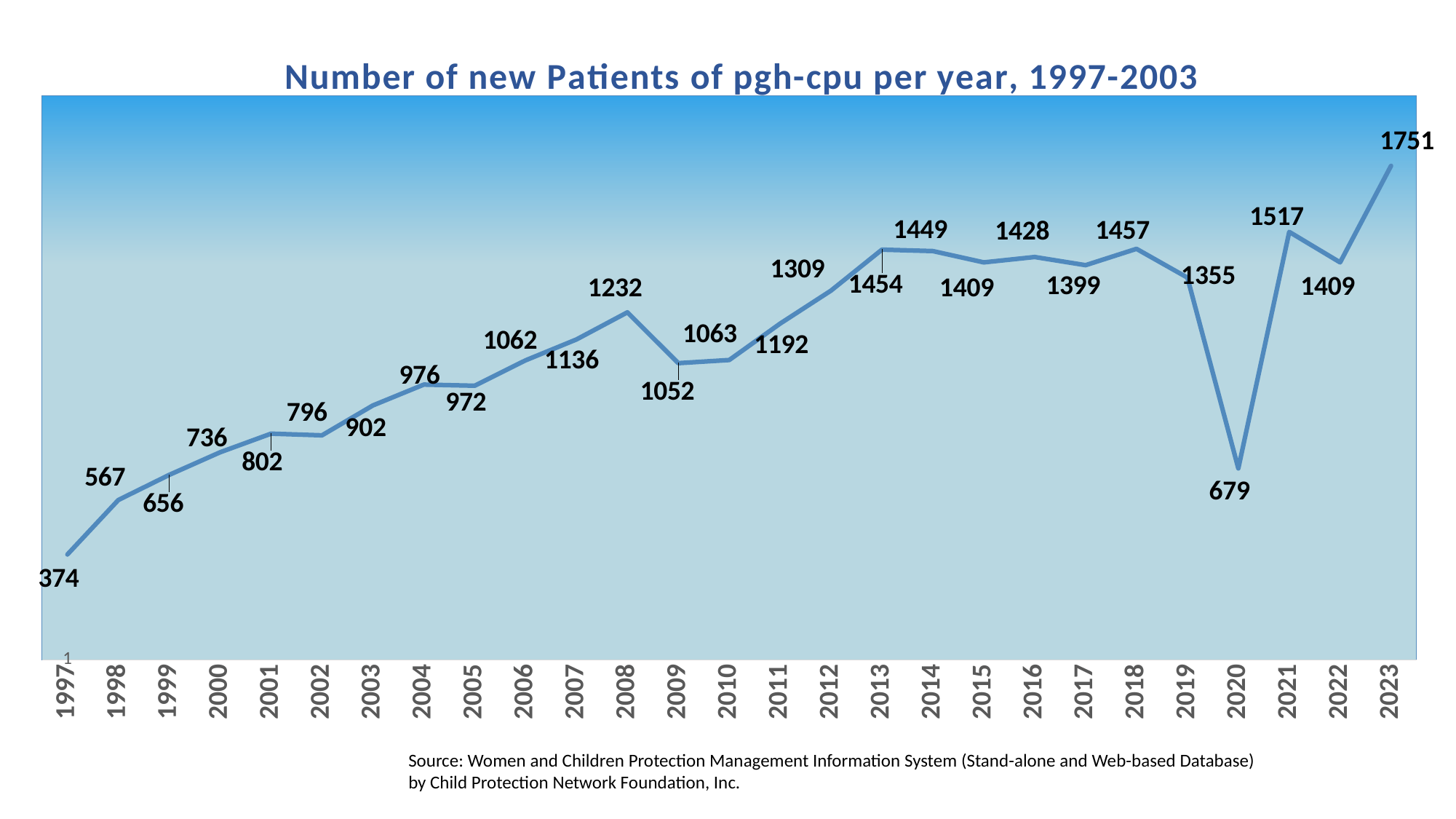
What is the title of the chart? Number of new Patients of pgh-cpu per year, 1997-2003 Did the number of new patients rise or fall from 2019 to 2020? fall What is the number of new patients in 2020? 679 Which year has the highest number of new patients? 2023 What is the difference between the number of new patients in 2021 and in 2020? 838 Which year had more new patients, 2008 or 2009? 2008 What is the number of new patients in 1997? 374 Which year has the lowest number of new patients? 1997 What type of chart is shown on the slide? line chart What is the number of new patients in 2023? 1751 How many years are plotted on the chart? 27 What is the number of new patients in 2008? 1232